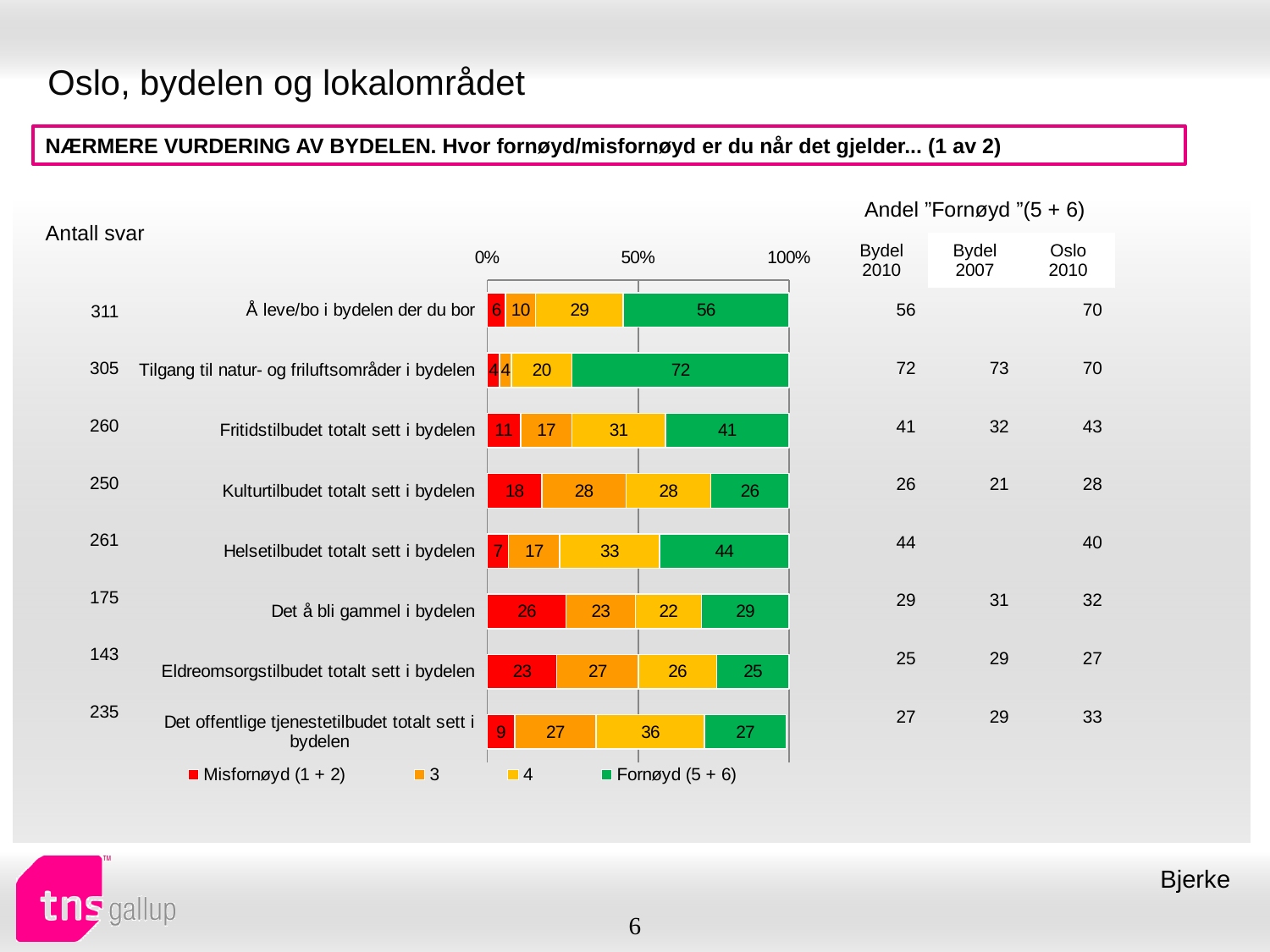
How many series does the chart legend list? 4 Which category has the highest Misfornøyd (1 + 2) value? Det å bli gammel i bydelen What is the difference between the Fornøyd (5 + 6) values for 'Å leve/bo i bydelen der du bor' and 'Helsetilbudet totalt sett i bydelen'? 12 Which has a larger Fornøyd (5 + 6) value: 'Fritidstilbudet totalt sett i bydelen' or 'Det å bli gammel i bydelen'? Fritidstilbudet totalt sett i bydelen What is the total of the stacked bar for 'Fritidstilbudet totalt sett i bydelen'? 100 What colour represents the Fornøyd (5 + 6) series in the chart? Green How many categories are plotted in the chart? 8 What is the Misfornøyd (1 + 2) value for 'Kulturtilbudet totalt sett i bydelen'? 18 What is the Fornøyd (5 + 6) value for 'Tilgang til natur- og friluftsområder i bydelen'? 72 What is the value of series '4' for 'Det offentlige tjenestetilbudet totalt sett i bydelen'? 36 What kind of chart is shown on the slide? Stacked bar chart Which category has the highest Fornøyd (5 + 6) value? Tilgang til natur- og friluftsområder i bydelen